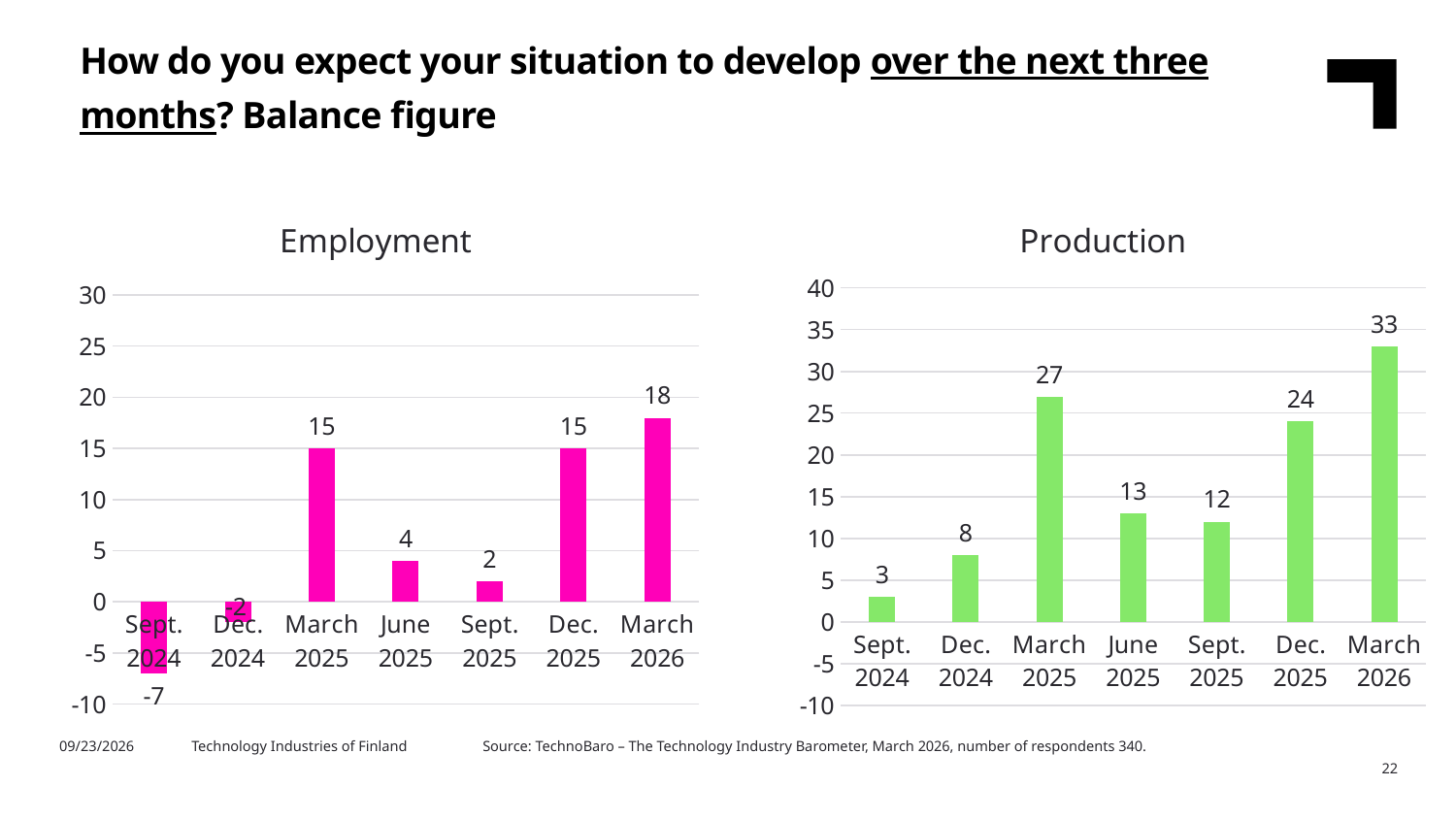
In the Employment chart, what is the value for March 2026? 18 In the Production chart, do the values rise or fall from Sept. 2025 to March 2026? rise In the Employment chart, which is larger, the value for Sept. 2025 or the value for Dec. 2025? Dec. 2025 In the Employment chart, what is the difference between March 2025 and June 2025? 11 How many periods are shown on the x axis of the Production chart? 7 What colour are the bars in the Production chart? green In the Production chart, is the value for March 2025 greater or less than 25? greater In the Employment chart, which period has the lowest value? Sept. 2024 In the Production chart, what is the value for Sept. 2025? 12 What kind of chart is the Employment chart? bar chart In the Production chart, which period has the highest value? March 2026 In the Production chart, what is the difference between March 2026 and Dec. 2025? 9